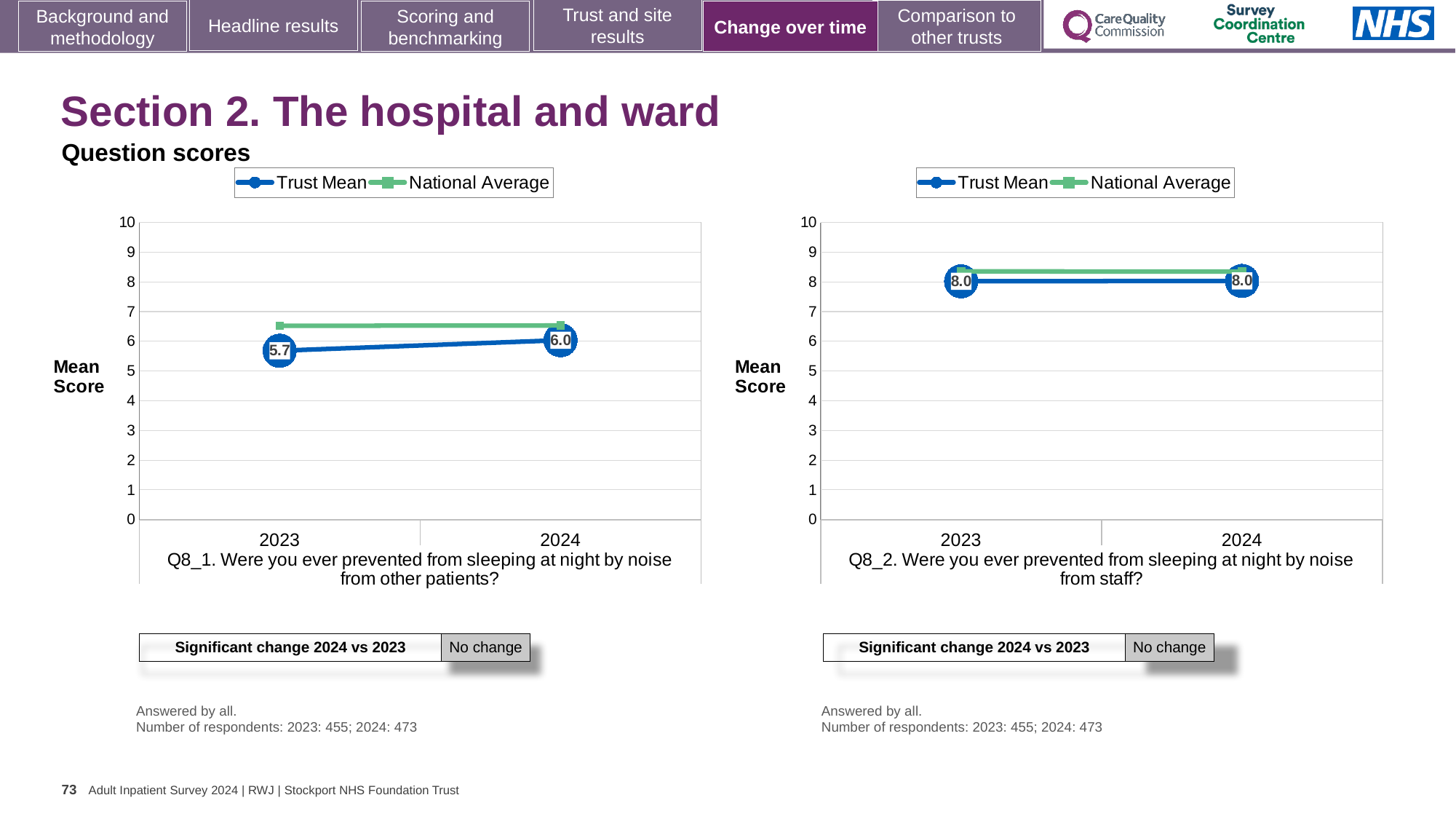
On the left chart (Q8_1), what is the Trust Mean score for 2024? 6.0 On the right chart (Q8_2), what is the Trust Mean score for 2024? 8.0 On the right chart (Q8_2), is the National Average for 2023 greater or less than 9? less On the left chart (Q8_1), what is the Trust Mean score for 2023? 5.7 On the left chart (Q8_1), does the Trust Mean rise or fall from 2023 to 2024? rise On the left chart (Q8_1), is the National Average for 2024 greater or less than 6? greater On the right chart (Q8_2), does the Trust Mean rise, fall or stay the same from 2023 to 2024? stay the same What type of chart is the left chart (Q8_1)? line chart On the left chart (Q8_1), by how much did the Trust Mean change from 2023 to 2024? 0.3 How many series does the legend of the right chart (Q8_2) list? 2 On the left chart (Q8_1), which is higher in 2023, the Trust Mean or the National Average? National Average How many years are plotted on the x axis of the right chart (Q8_2)? 2